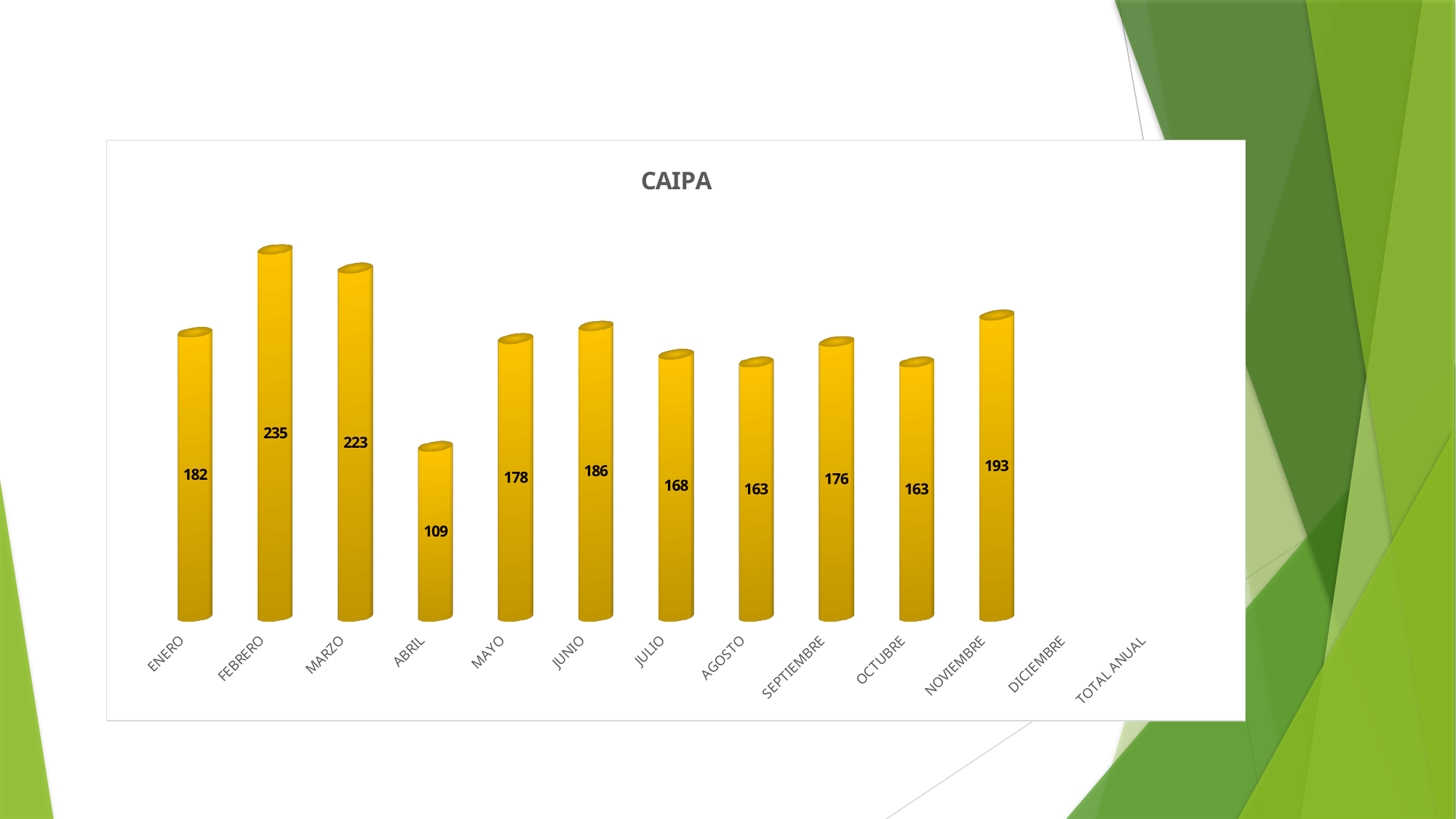
Which is larger in the CAIPA chart, the value for MAYO or the value for JUNIO? JUNIO What is the value for ABRIL in the CAIPA chart? 109 What is the value for SEPTIEMBRE in the CAIPA chart? 176 How many bars are plotted in the CAIPA chart? 11 What is the difference between the values for FEBRERO and MARZO in the CAIPA chart? 12 Which month has the highest value in the CAIPA chart? FEBRERO Which month has the lowest plotted value in the CAIPA chart? ABRIL What is the difference between the values for NOVIEMBRE and OCTUBRE in the CAIPA chart? 30 What kind of chart is the CAIPA chart? Bar chart What is the value for NOVIEMBRE in the CAIPA chart? 193 What is the value for ENERO in the CAIPA chart? 182 Do the values rise or fall from JUNIO to AGOSTO in the CAIPA chart? Fall